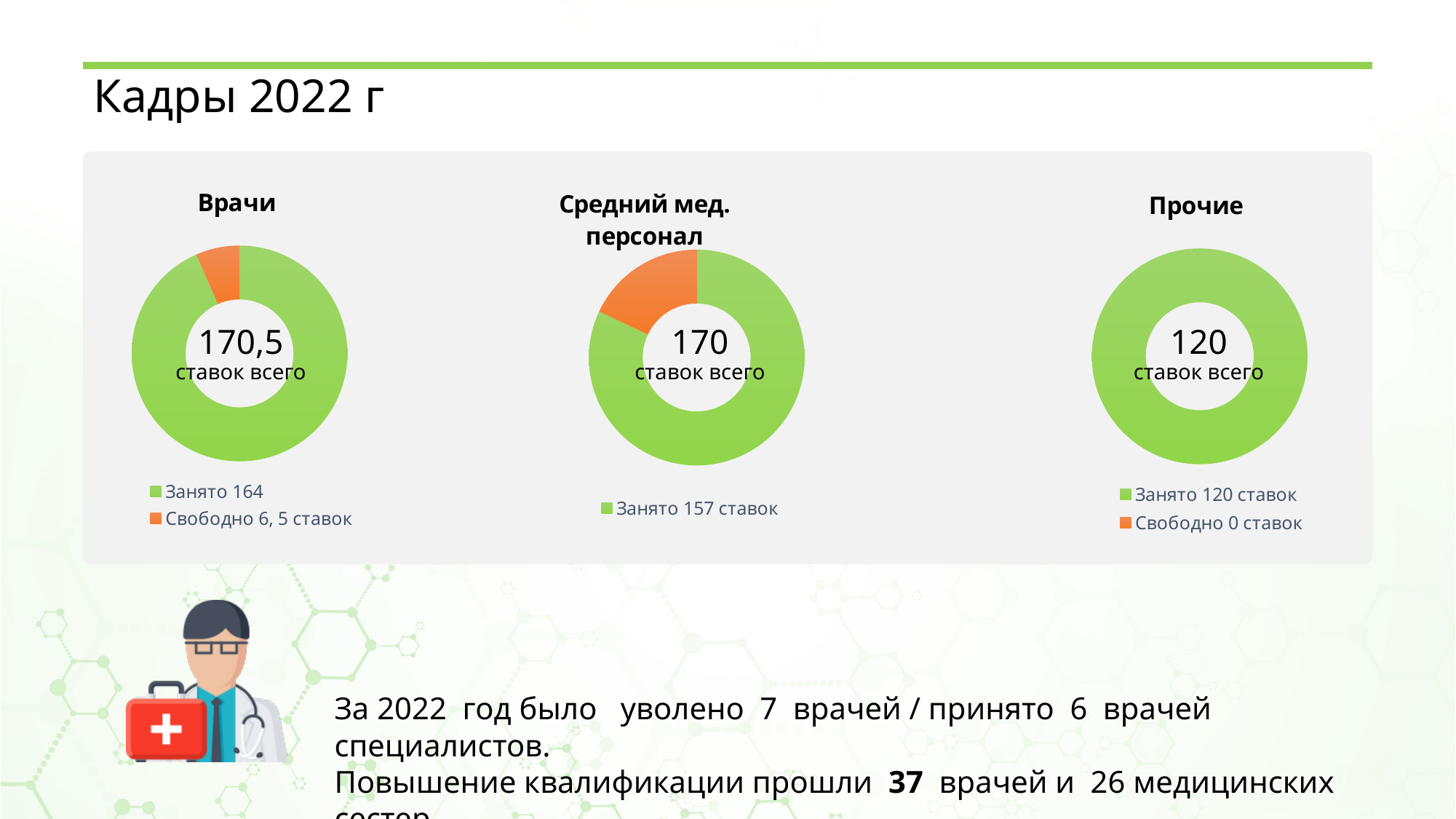
Which chart has the largest total number of ставок shown in its centre? Врачи How many entries does the legend of the "Прочие" chart list? 2 In the "Прочие" chart, how many ставок are "Свободно"? 0 How many charts are shown on the slide? 3 In the "Врачи" chart, what is the value for "Занято"? 164 In the "Средний мед. персонал" chart, what is the difference between the total ставок and the "Занято" value? 13 In the "Врачи" chart, what is the value for "Свободно"? 6, 5 ставок In the "Средний мед. персонал" chart, how many ставок are "Занято"? 157 In the "Средний мед. персонал" chart, how many ставок всего are shown in the centre? 170 What kind of chart is used for "Врачи"? doughnut chart In the "Врачи" chart, how many ставок всего are shown in the centre? 170,5 In the "Врачи" chart, which is larger, "Занято" or "Свободно"? Занято